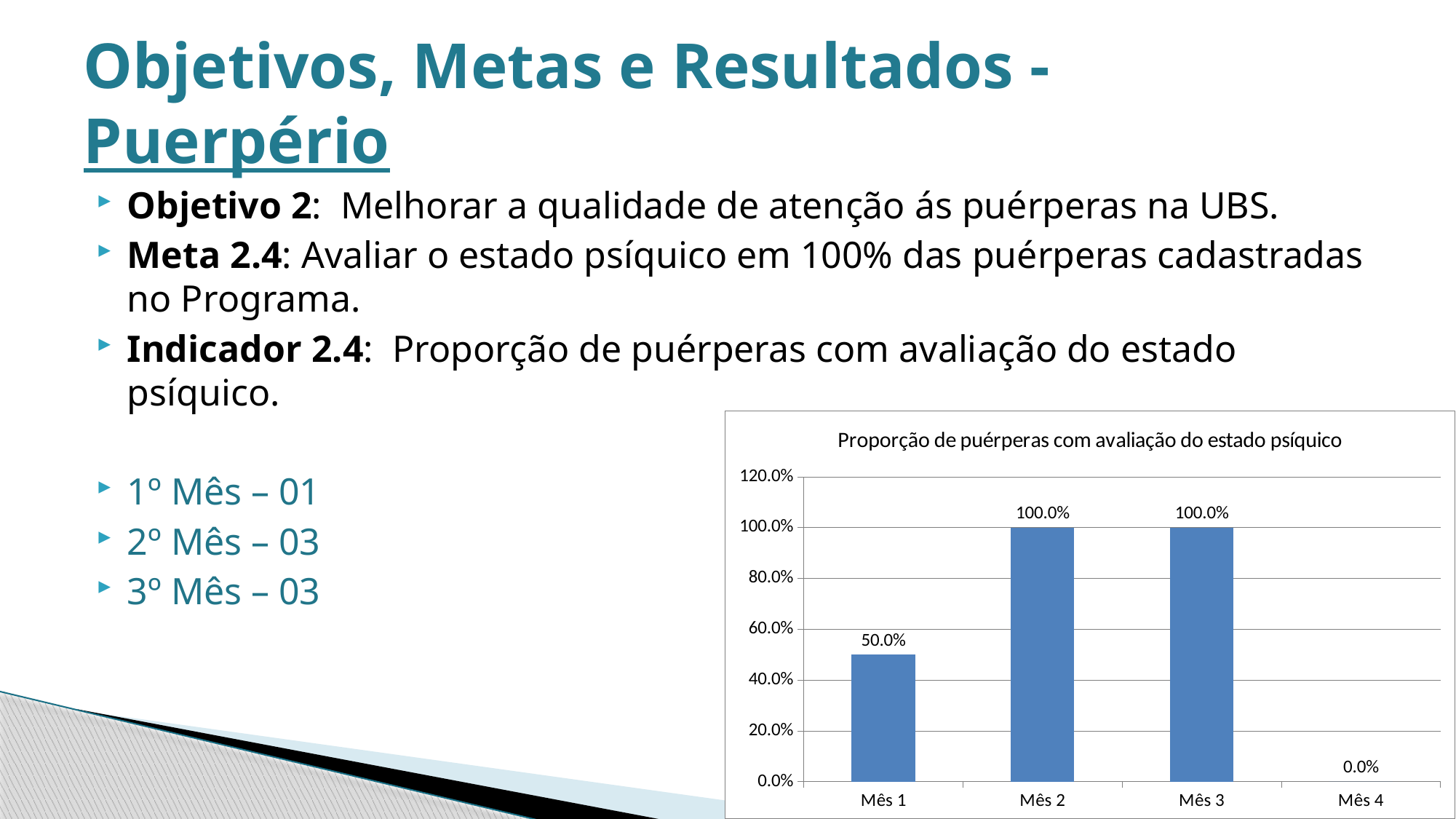
What is the value for Mês 1? 50.0% Do the values rise or fall from Mês 1 to Mês 2? rise What is the value for Mês 4? 0.0% How many categories are shown on the x axis? 4 Which category has the lowest value? Mês 4 Which is larger, the value for Mês 1 or the value for Mês 3? Mês 3 Is the value for Mês 1 greater or less than 40.0%? greater What is the value for Mês 2? 100.0% What kind of chart is shown? bar chart What is the highest value shown on the y axis? 120.0% What is the title of the chart? Proporção de puérperas com avaliação do estado psíquico What is the difference between the values for Mês 2 and Mês 1? 50.0%